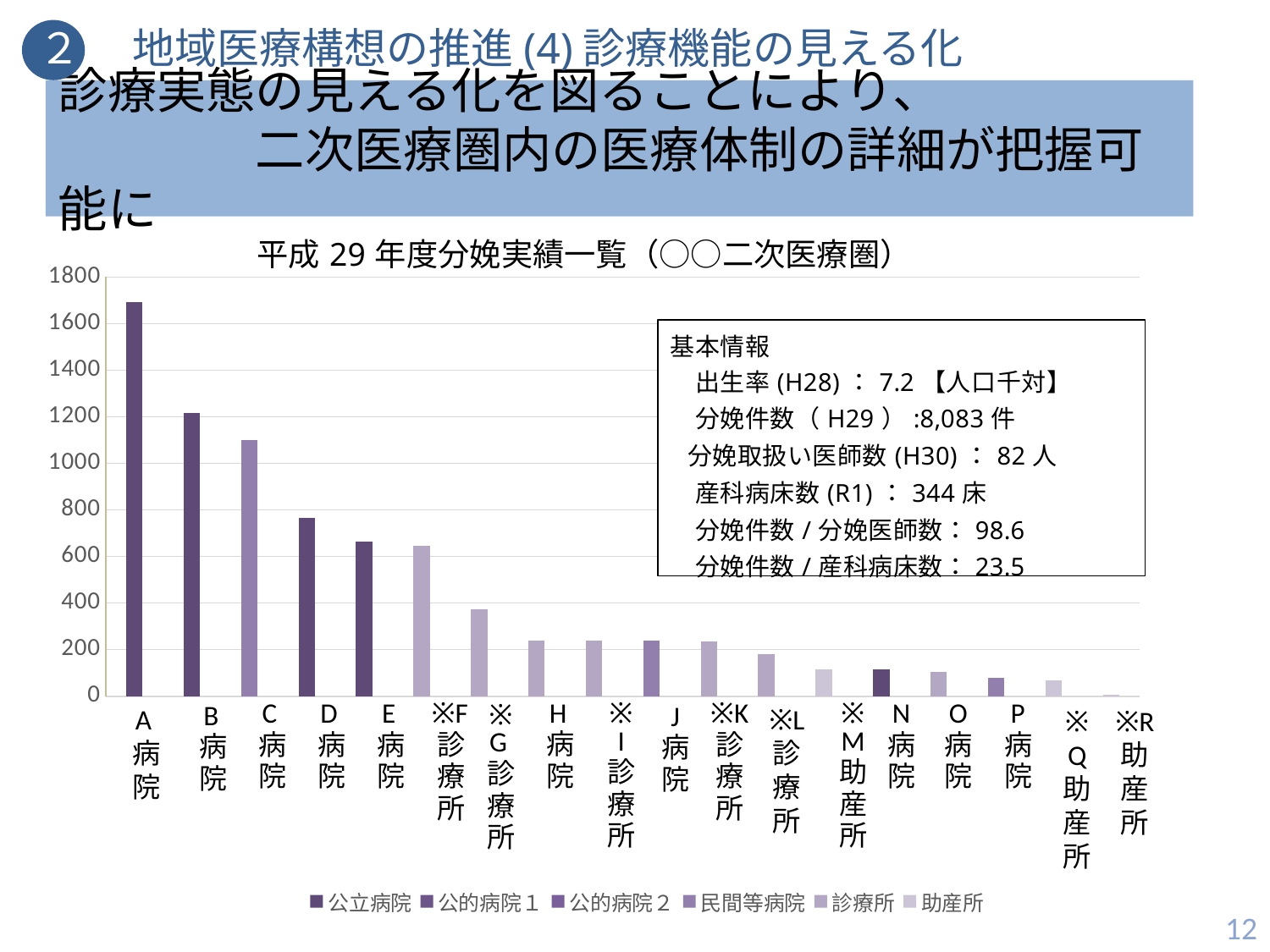
What kind of chart is shown on the slide? bar chart Which category has the highest value in the chart? A病院 Which category has the lowest value in the chart? ※R助産所 Is the value for A病院 greater or less than 1600? greater What is the title of the chart? 平成29年度分娩実績一覧（○○二次医療圏） Do the values generally rise or fall moving from left to right along the x axis? fall Is the value for C病院 greater or less than 1000? greater Is the value for D病院 greater or less than 800? less Which has the larger value, D病院 or ※G診療所? D病院 How many series does the chart legend list? 6 How many categories are plotted along the x axis of the chart? 18